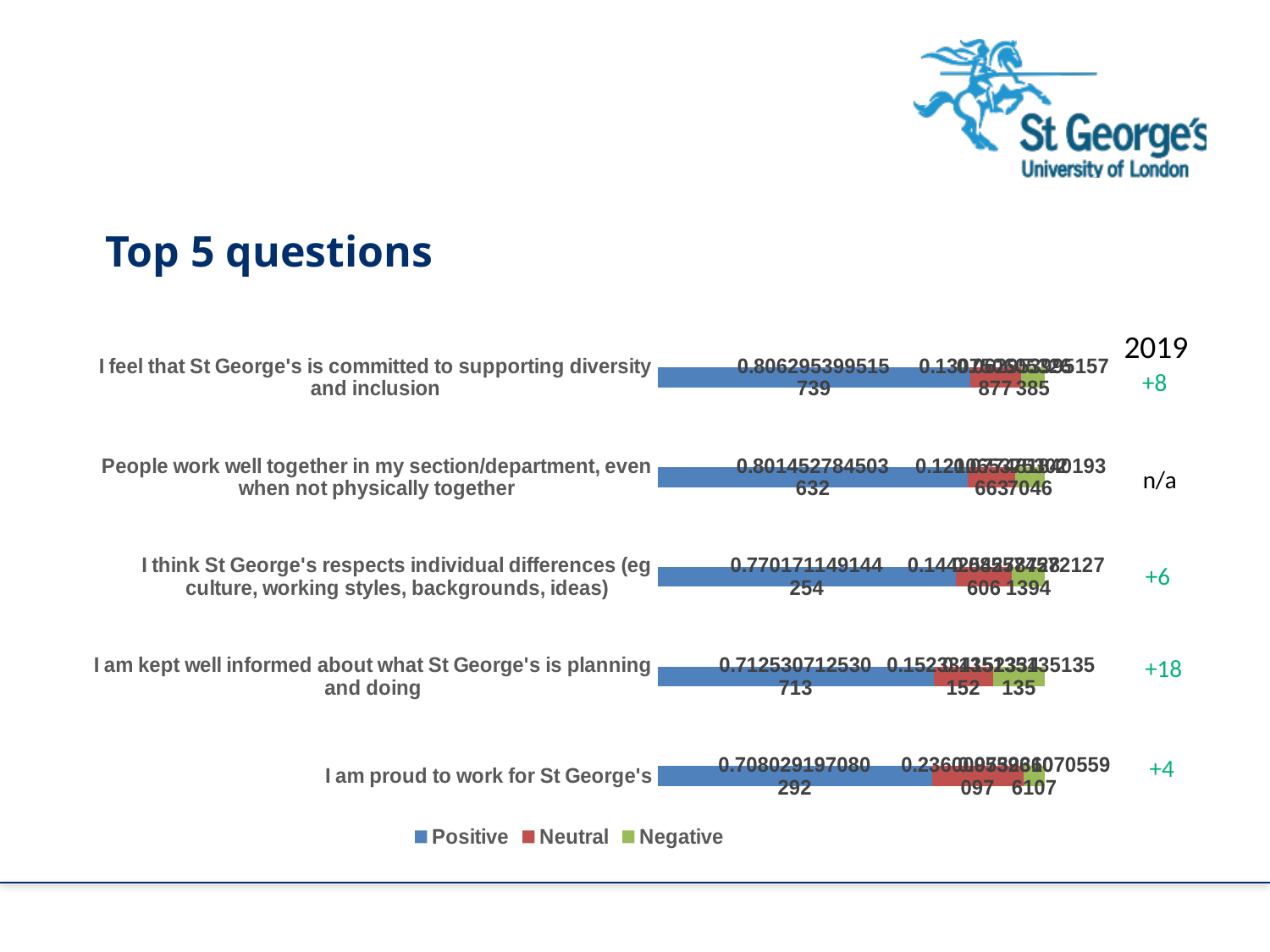
Which series makes up the largest part of each bar: Positive, Neutral or Negative? Positive What is the Positive value for "I am proud to work for St George's"? 0.708029197080292 What is the Positive value for "I feel that St George's is committed to supporting diversity and inclusion"? 0.806295399515739 What are the series names listed in the chart legend? Positive, Neutral, Negative What is the Positive value for "I think St George's respects individual differences (eg culture, working styles, backgrounds, ideas)"? 0.770171149144254 What kind of chart is shown on the slide? Stacked horizontal bar chart How many questions (categories) are plotted in the chart? 5 Which question has the lowest Positive value? I am proud to work for St George's How many series does the chart legend list? 3 What colour represents the Positive series in the chart? Blue What is the Positive value for "People work well together in my section/department, even when not physically together"? 0.801452784503632 Which question has the highest Positive value? I feel that St George's is committed to supporting diversity and inclusion